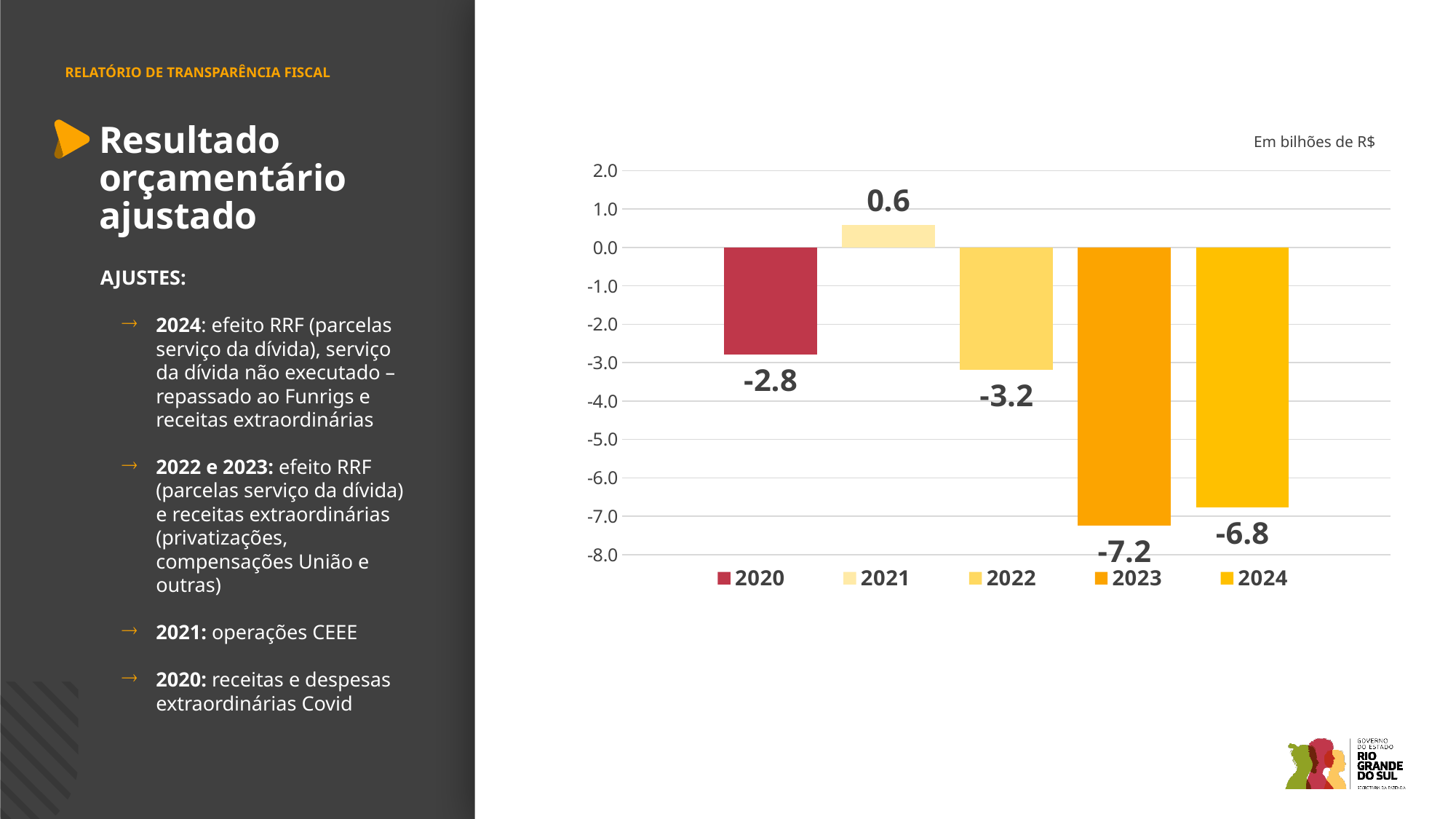
How many years are shown in the chart? 5 What is the value for 2023? -7.2 What is the value for 2020? -2.8 Which year has the highest value? 2021 What is the difference between the values for 2023 and 2024? 0.4 Which is larger, the value for 2020 or the value for 2022? 2020 What is the value for 2021? 0.6 What kind of chart is shown? bar chart Is the value for 2022 greater or less than -2.0? less Which year has the lowest value? 2023 What is the value for 2024? -6.8 What unit is stated for the chart values? Em bilhões de R$